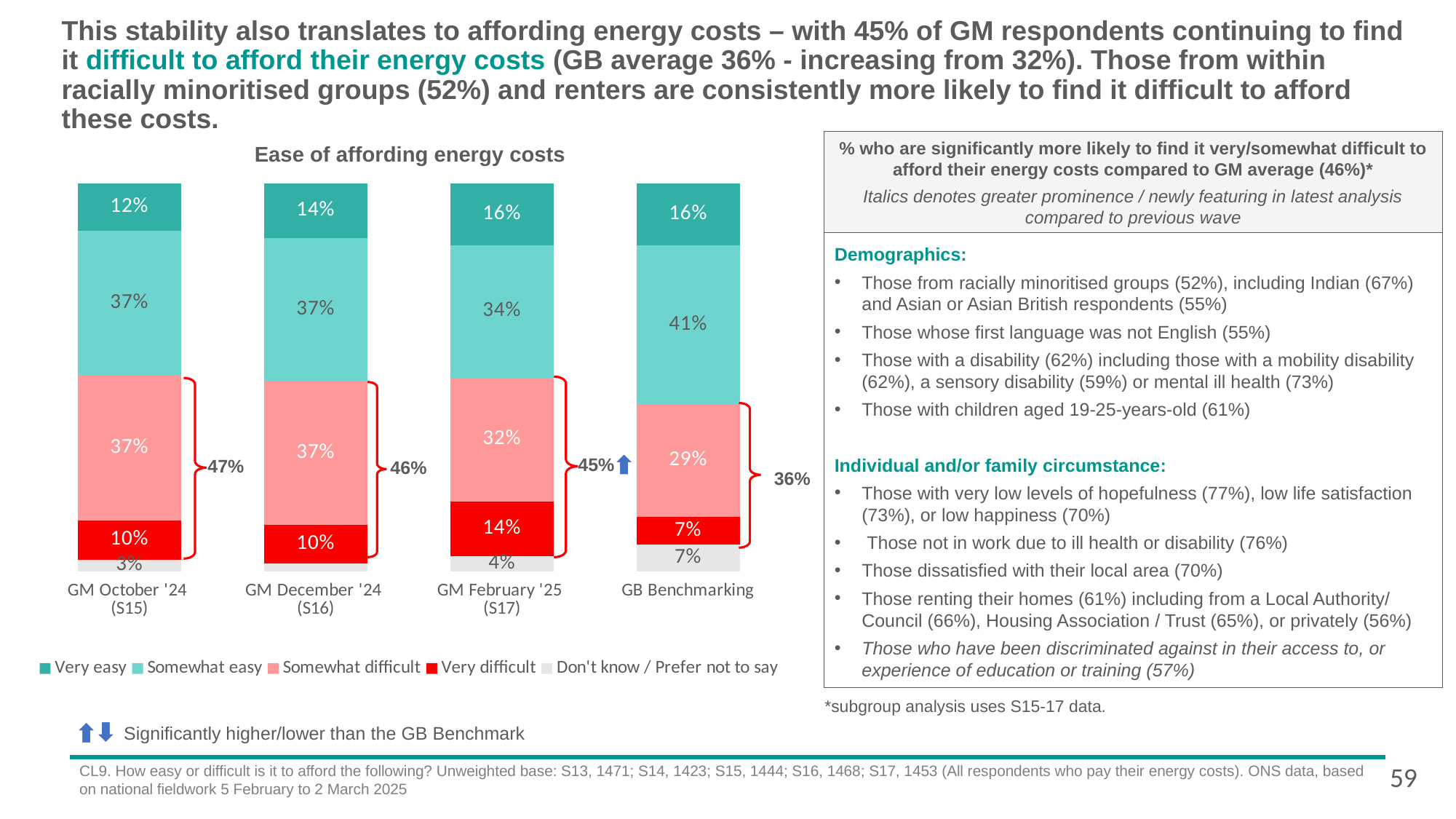
How many series does the legend of the "Ease of affording energy costs" chart list? 5 What is the "Somewhat easy" value for GB Benchmarking? 41% What is the "Very easy" value for GM October '24 (S15)? 12% What is the difference between the "Somewhat difficult" values for GM October '24 (S15) and GB Benchmarking? 8% Does the "Very easy" value rise or fall across the three GM waves from October '24 to February '25? Rise What is the combined "Somewhat difficult" plus "Very difficult" share shown by the bracket for GM December '24 (S16)? 46% Which category has the lowest "Somewhat difficult" value? GB Benchmarking What type of chart is shown under the title "Ease of affording energy costs"? Stacked bar chart Which is larger: the "Very easy" value for GM December '24 (S16) or for GM February '25 (S17)? GM February '25 (S17) Which category has the highest "Very difficult" value? GM February '25 (S17) What is the "Very difficult" value for GM February '25 (S17)? 14% How many bars (categories) are shown in the "Ease of affording energy costs" chart? 4